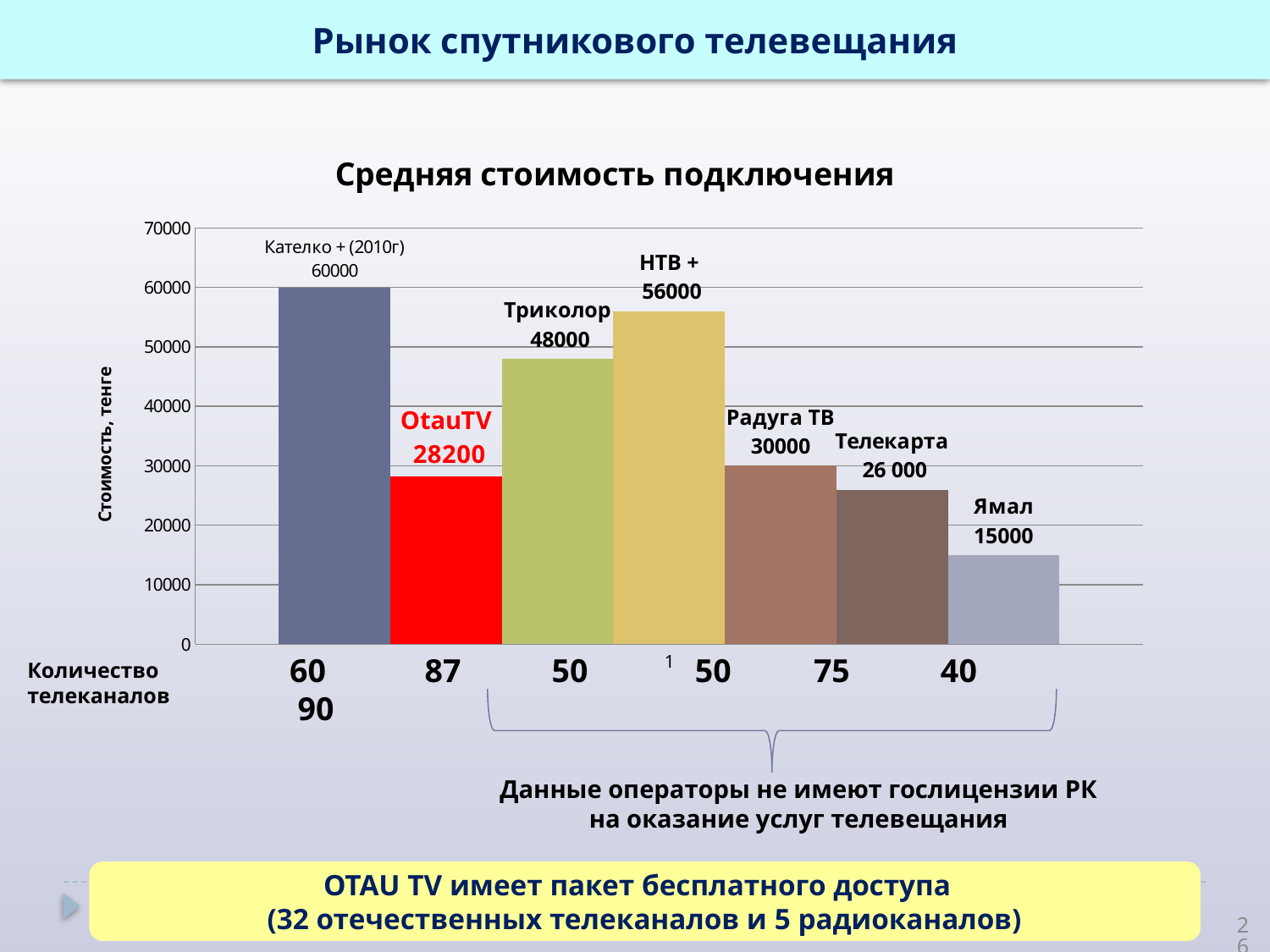
Which operator has the highest average connection cost? Кателко + (2010г) Which operator has the lowest average connection cost? Ямал What is the value shown for НТВ +? 56000 What is the value shown for Телекарта? 26 000 What type of chart is shown on the slide? bar chart What is the title of the chart? Средняя стоимость подключения What is the label of the vertical axis? Стоимость, тенге How many bars (operators) are plotted in the chart? 7 What is the value shown for OtauTV? 28200 Which is larger, the value for Радуга ТВ or the value for Телекарта? Радуга ТВ Is the value for Ямал greater or less than 20000? less What is the difference between the values for Триколор and OtauTV? 19800